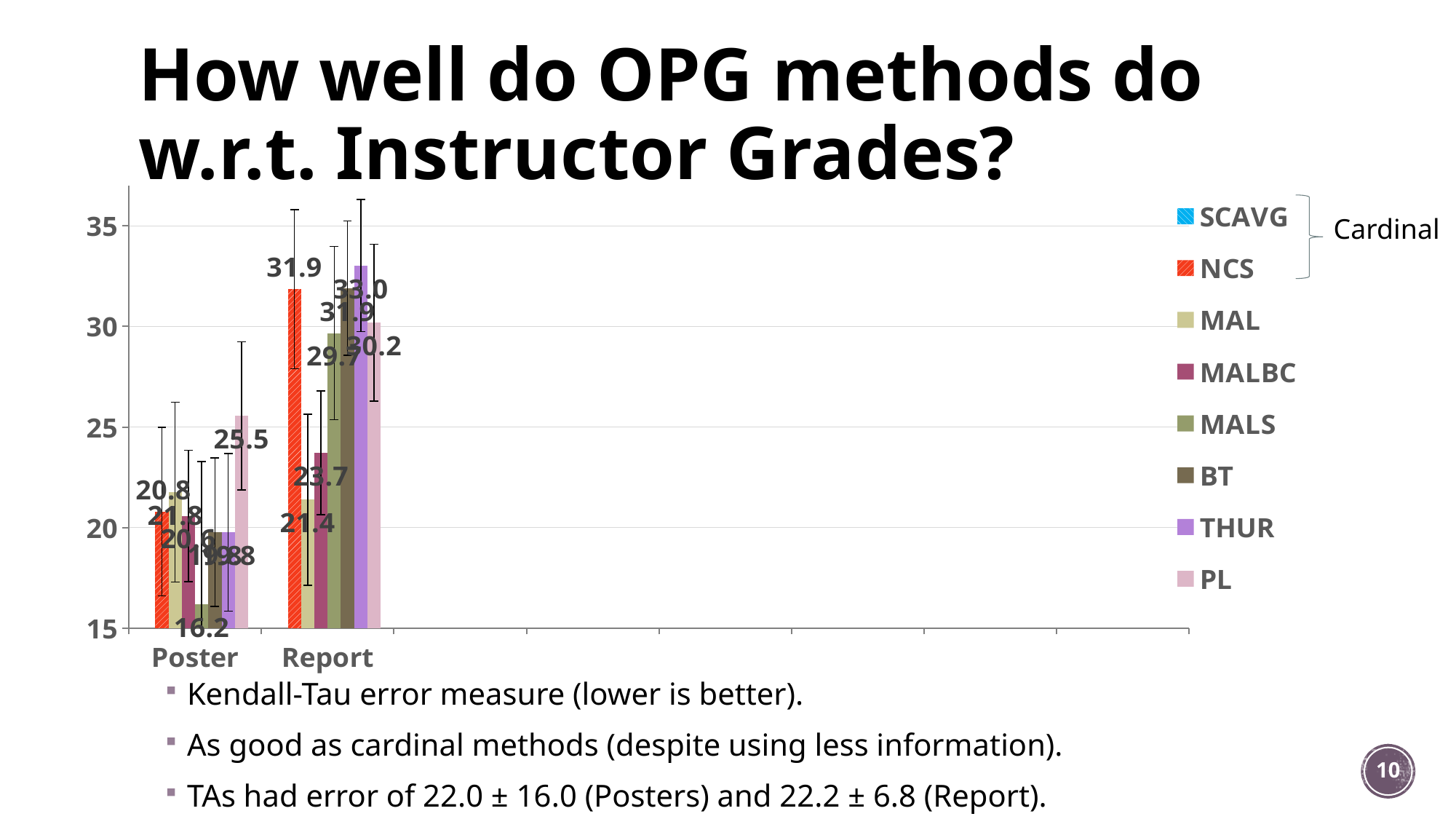
Is the value for PL larger in the Poster or the Report category? Report What is the value for NCS in the Report category? 31.9 What is the difference between the PL and MALS values in the Poster category? 9.3 Which series has the lowest value in the Report category? MAL What is the value for PL in the Poster category? 25.5 Which legend entries are grouped under the label "Cardinal"? SCAVG and NCS How many series does the legend list? 8 What is the value for MALS in the Poster category? 16.2 Which series has the lowest value in the Poster category? MALS Which series has the highest value in the Report category? THUR Is the value for MALS in the Report category greater or less than 25? greater What is the value for THUR in the Report category? 33.0